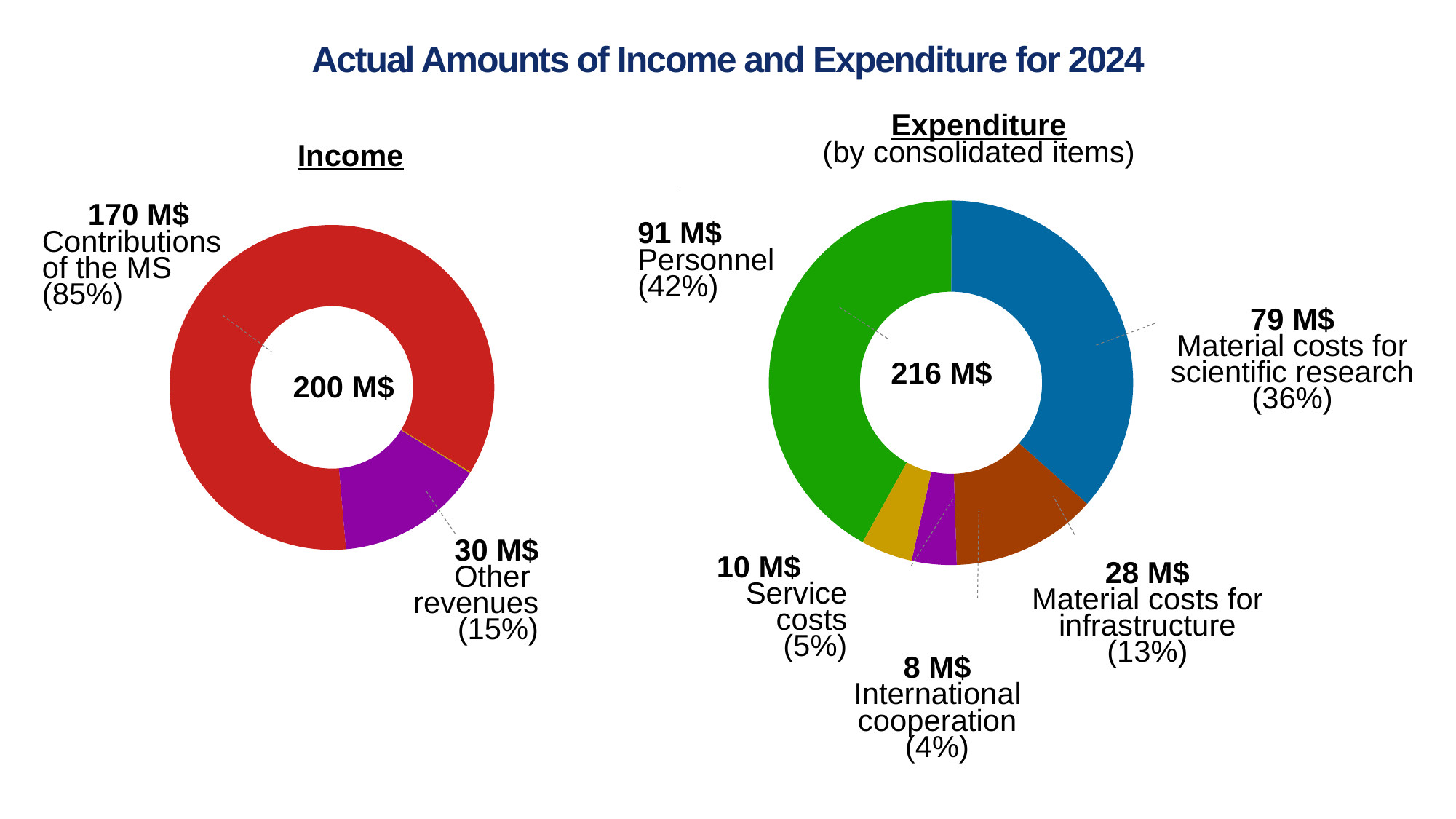
In the Expenditure chart, what is the difference between Personnel and Material costs for scientific research? 12 M$ In the Income chart, what total is shown in the centre of the donut? 200 M$ In the Income chart, what share of the total is Other revenues? 15% In the Income chart, what is the value for Contributions of the MS? 170 M$ In the Expenditure chart, which item has the lowest value? International cooperation In the Expenditure chart, which item has the highest value? Personnel In the Expenditure chart, what share of the total is Material costs for scientific research? 36% In the Expenditure chart, which is larger: Material costs for infrastructure or Service costs? Material costs for infrastructure What kind of chart is the Income chart? Donut (pie) chart In the Expenditure chart, what is the value for Personnel? 91 M$ In the Expenditure chart, how many items are shown? 5 In the Income chart, what is the difference between Contributions of the MS and Other revenues? 140 M$